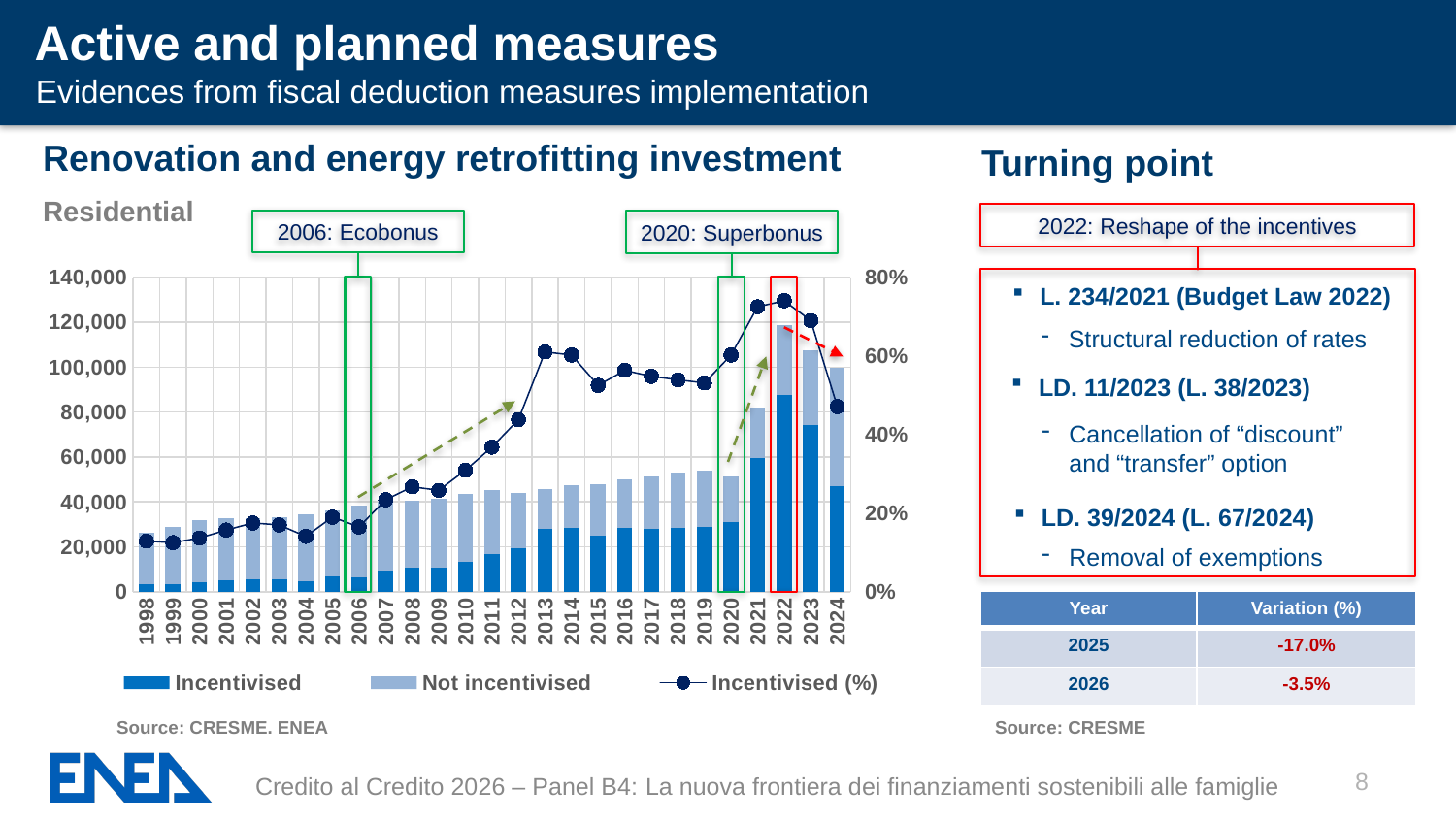
How many series does the chart legend list? 3 Which year has the larger total stacked bar, 2022 or 2023? 2022 Is the Incentivised (%) value for 2021 greater or less than 60%? greater Which year has the tallest stacked bar in the chart? 2022 Is the Incentivised (%) value for 2010 greater or less than 40%? less What kind of chart is shown under "Renovation and energy retrofitting investment"? A combined stacked bar and line chart Does the Incentivised (%) line rise or fall between 2006 and 2013? Rise How many years are shown on the x axis of the chart? 27 Which year has the shortest stacked bar in the chart? 1998 Do the total stacked bars rise or fall from 2022 to 2024? Fall Is the total stacked bar for 2022 greater or less than 100,000? greater Which measure does the chart annotation associate with the year 2020? Superbonus